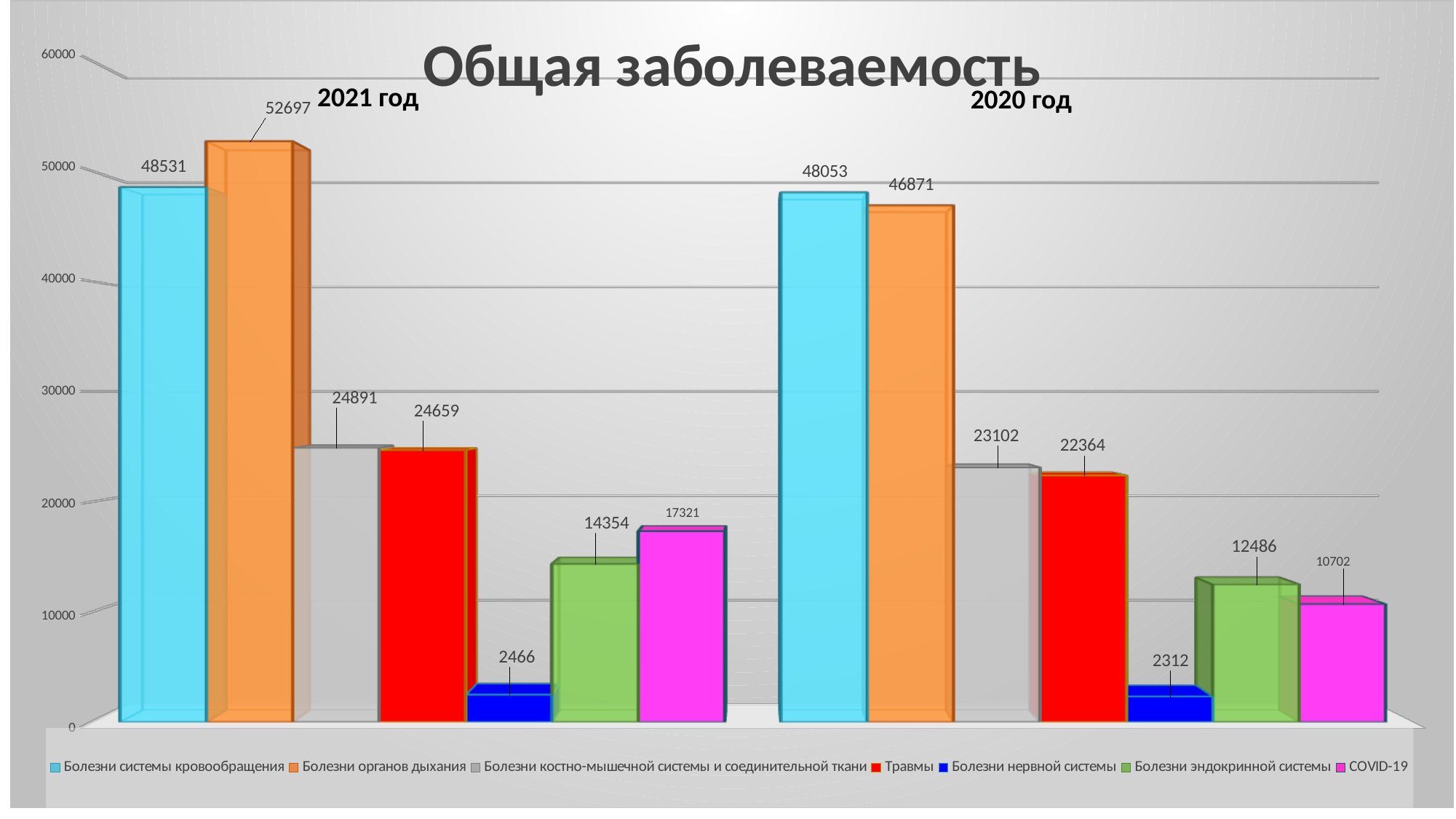
What is the title of the chart? Общая заболеваемость What type of chart is shown on the slide? bar chart Which series has the lowest value in 2021 год? Болезни нервной системы Is the value for Болезни костно-мышечной системы и соединительной ткани in 2020 год greater or less than 20000? greater Which series has the highest value in 2020 год? Болезни системы кровообращения Which is larger: the value for Болезни эндокринной системы in 2021 год or the value for COVID-19 in 2021 год? COVID-19 in 2021 год What is the difference between the value for Болезни органов дыхания in 2021 год and in 2020 год? 5826 What is the value for Болезни органов дыхания in 2021 год? 52697 How many year groups are shown on the x axis? 2 How many series does the legend list? 7 What is the value for COVID-19 in 2020 год? 10702 What is the value for Травмы in 2021 год? 24659